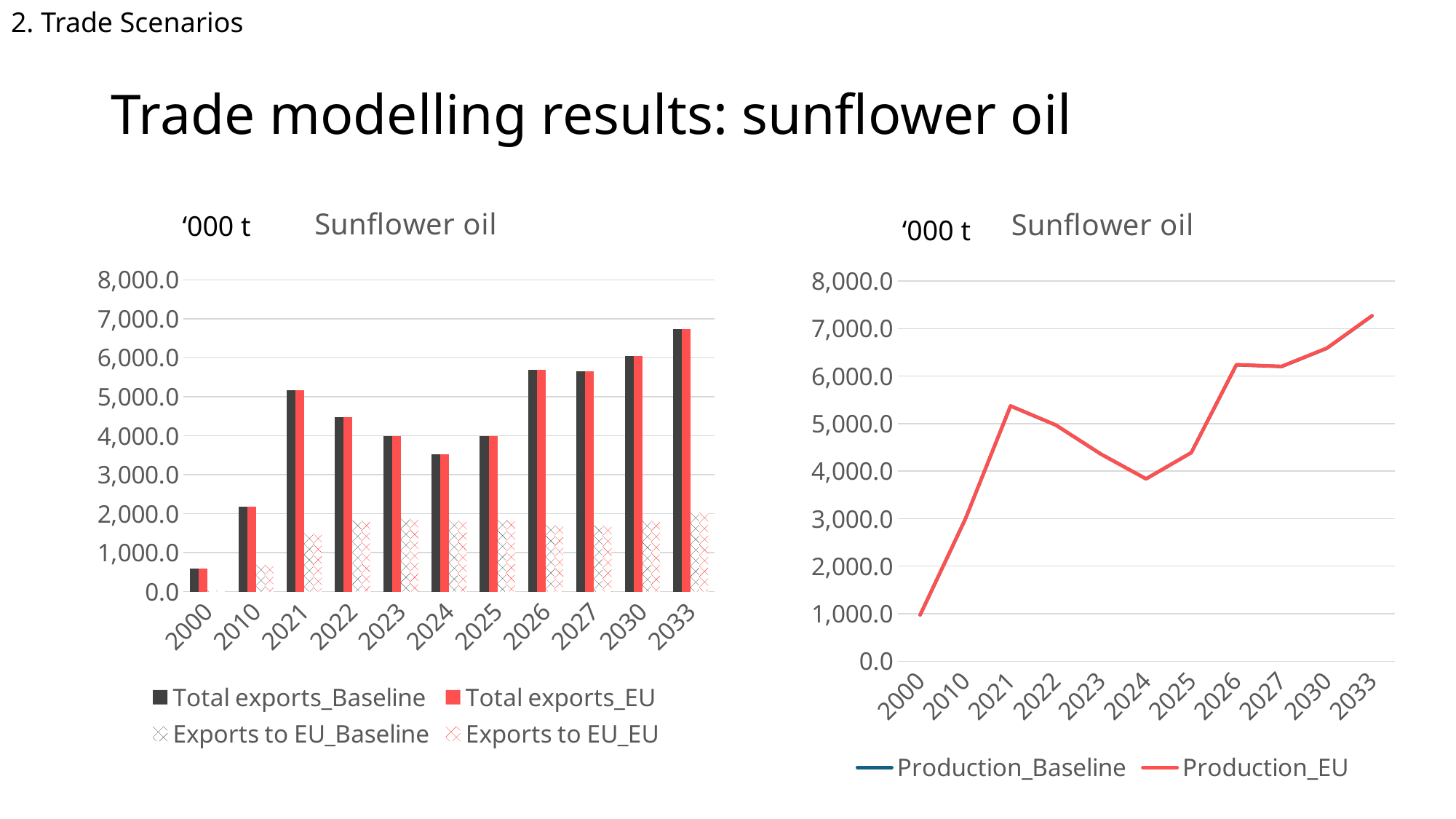
What kind of chart is the right chart on the slide? line chart In the right line chart, is the Production_EU value for 2021 greater or less than 5,000.0? greater In the left bar chart, which year has the highest Total exports_Baseline value? 2033 In the left bar chart, which year has the lowest Total exports_EU value? 2000 In the left bar chart, how many years are shown on the x axis? 11 In the left bar chart, how many series does the legend list? 4 In the left bar chart, is the Total exports_Baseline value for 2000 greater or less than 1,000.0? less In the right line chart, does the Production_EU line rise or fall from 2024 to 2033? rise What kind of chart is the left chart on the slide? bar chart In the right line chart, which year has the highest Production_EU value? 2033 In the left bar chart, is the Total exports_EU value for 2022 greater or less than 4,000.0? greater In the right line chart, how many series does the legend list? 2